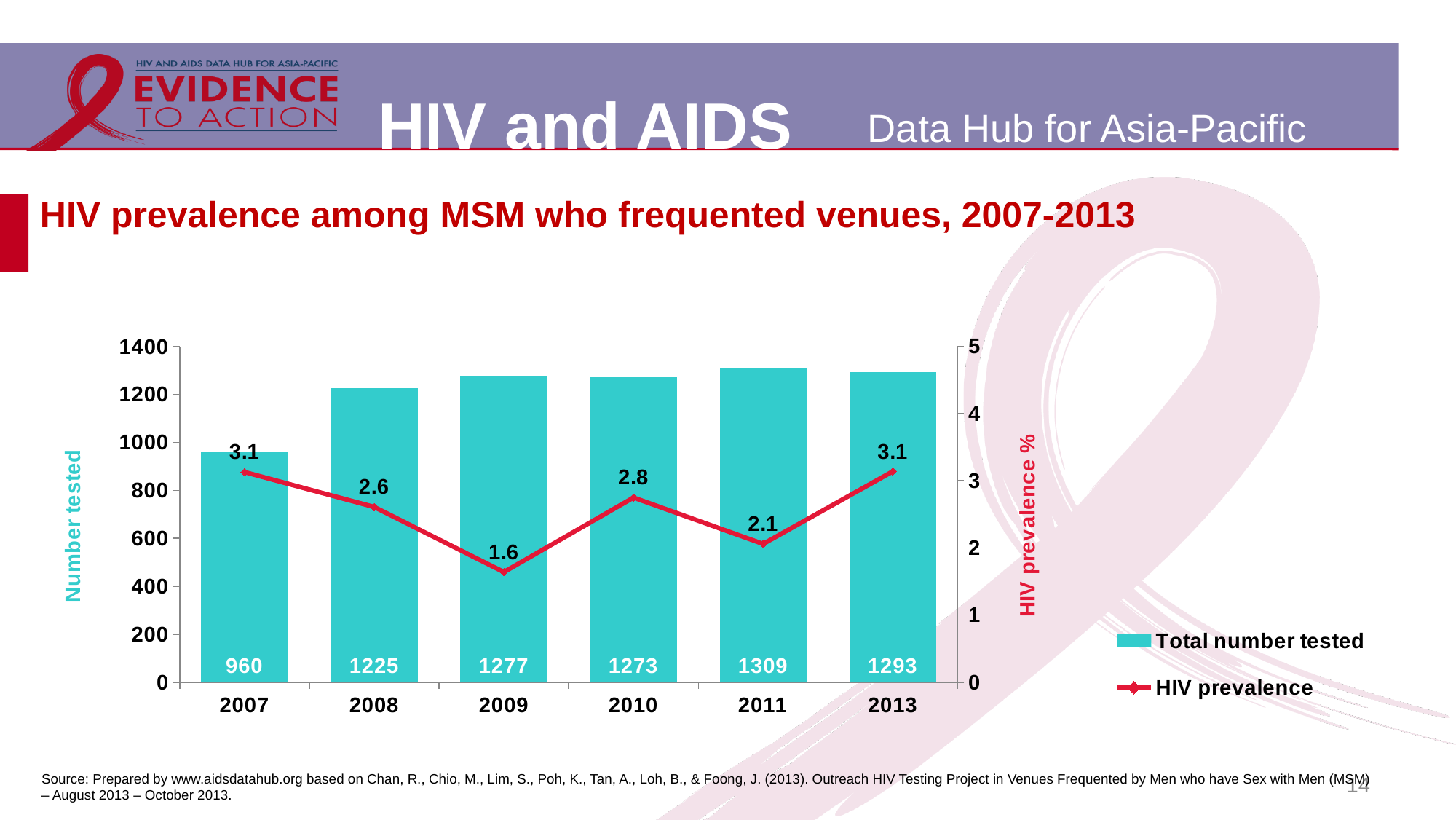
Was the HIV prevalence higher in 2008 or in 2010? 2010 How many years are shown on the x axis? 6 What is the label of the right-hand vertical axis? HIV prevalence % What is the difference in total number tested between 2011 and 2007? 349 What is the difference in HIV prevalence between 2010 and 2009? 1.2 Which year had the highest total number tested? 2011 How many series does the legend list? 2 Which year had the lowest total number tested? 2007 Which year had the lowest HIV prevalence? 2009 Did the HIV prevalence rise or fall from 2011 to 2013? rise What was the total number tested in 2009? 1277 What was the HIV prevalence in 2011? 2.1